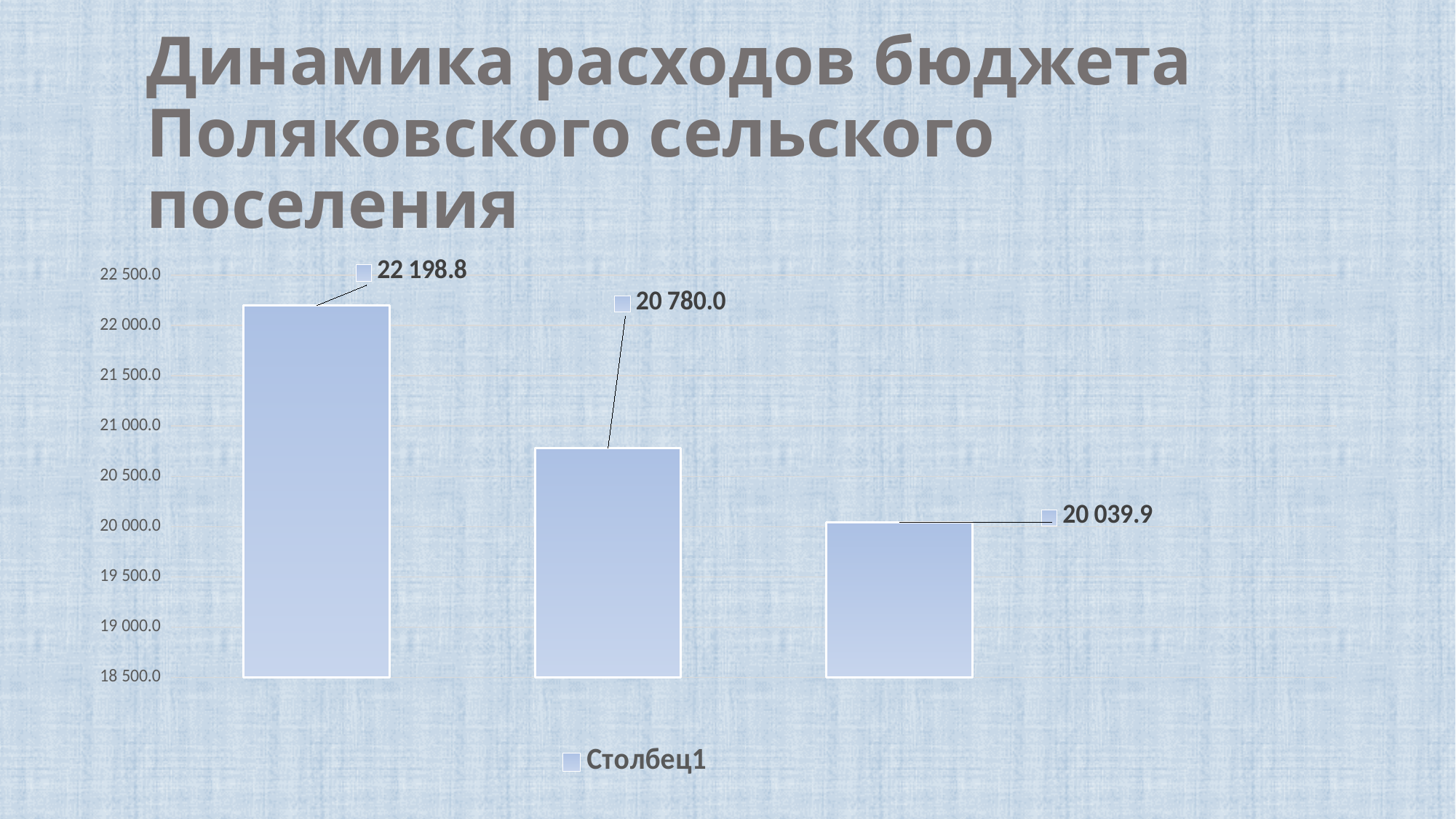
What is the difference between the middle bar's value (20 780.0) and the rightmost bar's value (20 039.9)? 740.1 How many bars are plotted in the chart? 3 Do the bar values rise or fall from left to right? fall What is the data label on the third (rightmost) bar? 20 039.9 What is the data label on the first (leftmost) bar? 22 198.8 Is the value of the leftmost bar greater or less than 22 000.0? greater What is the data label on the middle bar? 20 780.0 Which bar has the highest value: the left, middle or right one? the left one Which bar has the lowest value: the left, middle or right one? the right one What kind of chart is shown on the slide? bar chart What is the difference between the first bar's value (22 198.8) and the middle bar's value (20 780.0)? 1 418.8 Which is larger, the value of the middle bar or the value of the rightmost bar? the middle bar